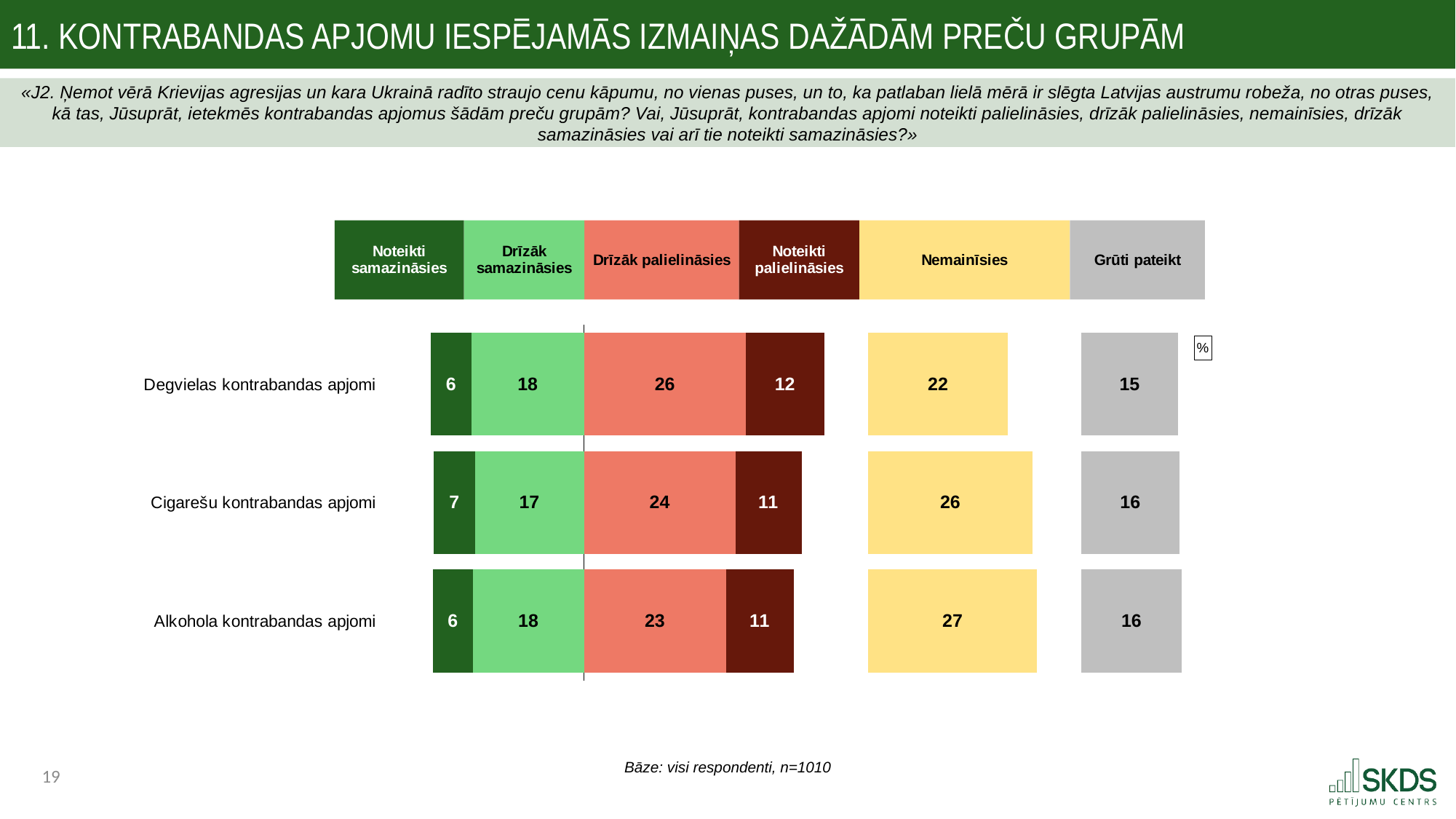
Which product group has the highest "Nemainīsies" value? Alkohola kontrabandas apjomi How many response categories does the legend list? 6 What is the value for "Nemainīsies" for Alkohola kontrabandas apjomi? 27 Which product group has the lowest "Drīzāk palielināsies" value? Alkohola kontrabandas apjomi What is the difference between the "Nemainīsies" values for Alkohola kontrabandas apjomi and Degvielas kontrabandas apjomi? 5 What percentage of respondents answered "Drīzāk palielināsies" for Degvielas kontrabandas apjomi? 26 What is the "Grūti pateikt" value for Cigarešu kontrabandas apjomi? 16 Which has a larger "Noteikti palielināsies" value: Degvielas kontrabandas apjomi or Cigarešu kontrabandas apjomi? Degvielas kontrabandas apjomi What kind of chart is shown on the slide? Stacked bar chart What colour represents "Nemainīsies" in the chart? Yellow What is the total of all six values for Degvielas kontrabandas apjomi? 99 How many product groups are shown in the chart? 3